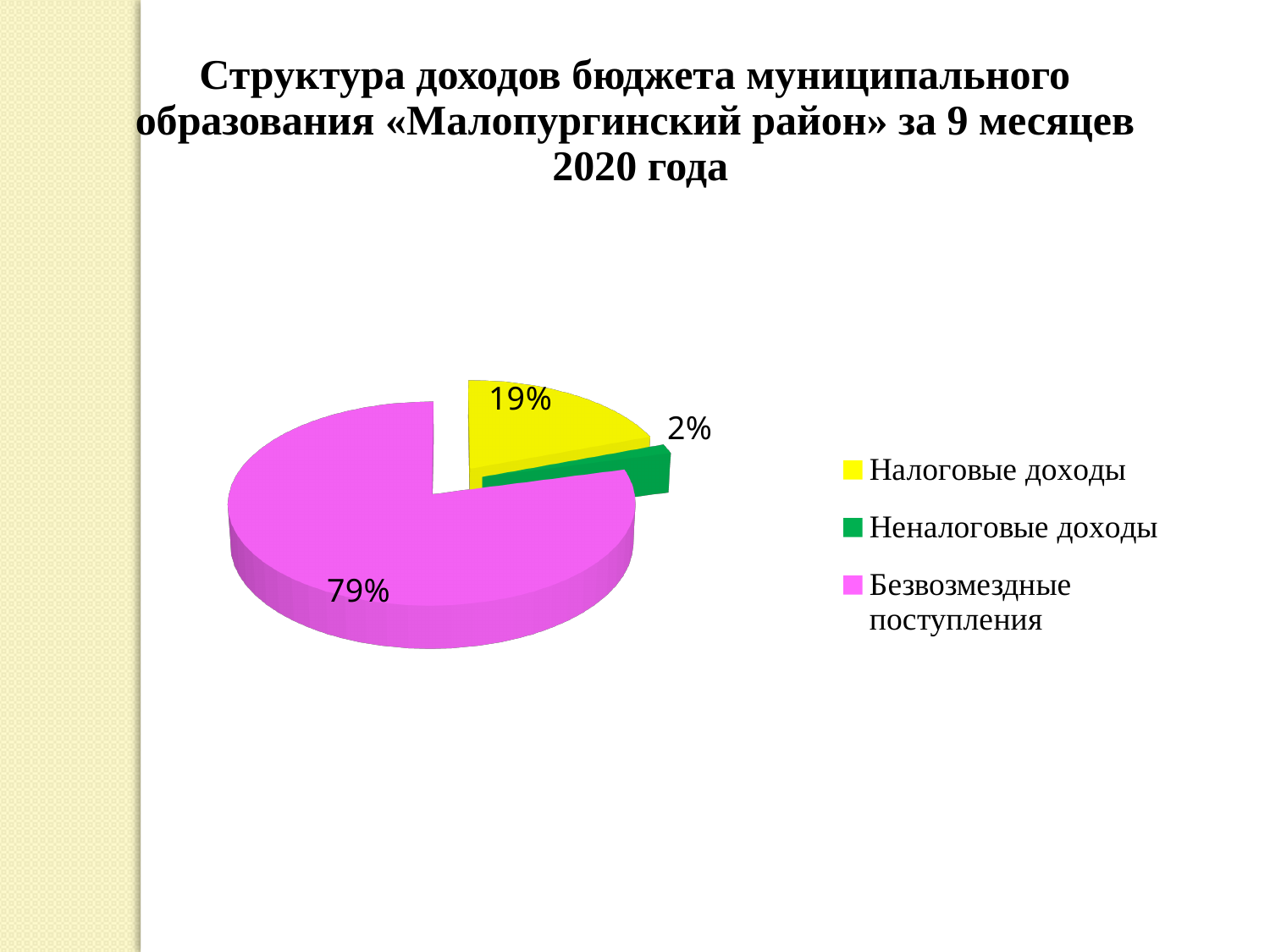
Which is larger, the share for Налоговые доходы or the share for Неналоговые доходы? Налоговые доходы How many categories are shown in the pie chart? 3 What share of the pie does Налоговые доходы represent? 19% Which legend entry is shown in green? Неналоговые доходы Which category has the largest slice of the pie? Безвозмездные поступления What colour is the slice for Безвозмездные поступления? Pink What is the difference in percentage points between Безвозмездные поступления and Налоговые доходы? 60 What is the difference in percentage points between Налоговые доходы and Неналоговые доходы? 17 What kind of chart is shown on the slide? Pie chart Which category has the smallest slice of the pie? Неналоговые доходы What share of the pie does Безвозмездные поступления represent? 79% What share of the pie does Неналоговые доходы represent? 2%